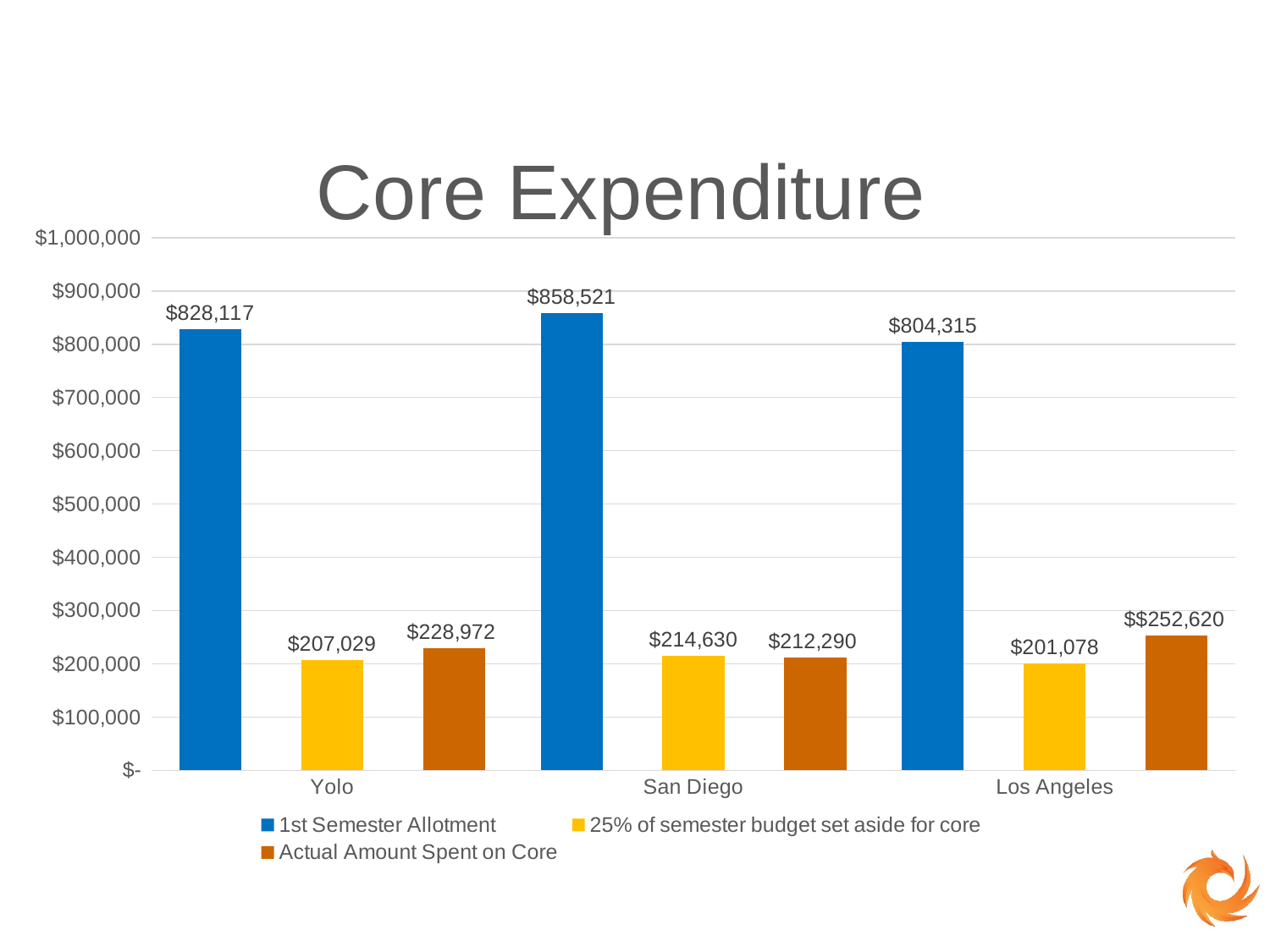
What is the 1st Semester Allotment for Los Angeles? $804,315 For Yolo, how much more was the Actual Amount Spent on Core than the 25% of semester budget set aside for core? $21,943 How many series does the legend list? 3 What is the 1st Semester Allotment for Yolo? $828,117 Which region has the highest 1st Semester Allotment? San Diego What is the 25% of semester budget set aside for core for San Diego? $214,630 Is the 1st Semester Allotment for Los Angeles greater or less than $900,000? less How many regions are shown on the x axis? 3 Which region has the lowest 25% of semester budget set aside for core? Los Angeles For Los Angeles, which is larger: the Actual Amount Spent on Core or the 25% of semester budget set aside for core? Actual Amount Spent on Core What is the difference between the 1st Semester Allotment for San Diego and for Yolo? $30,404 What is the Actual Amount Spent on Core for Yolo? $228,972